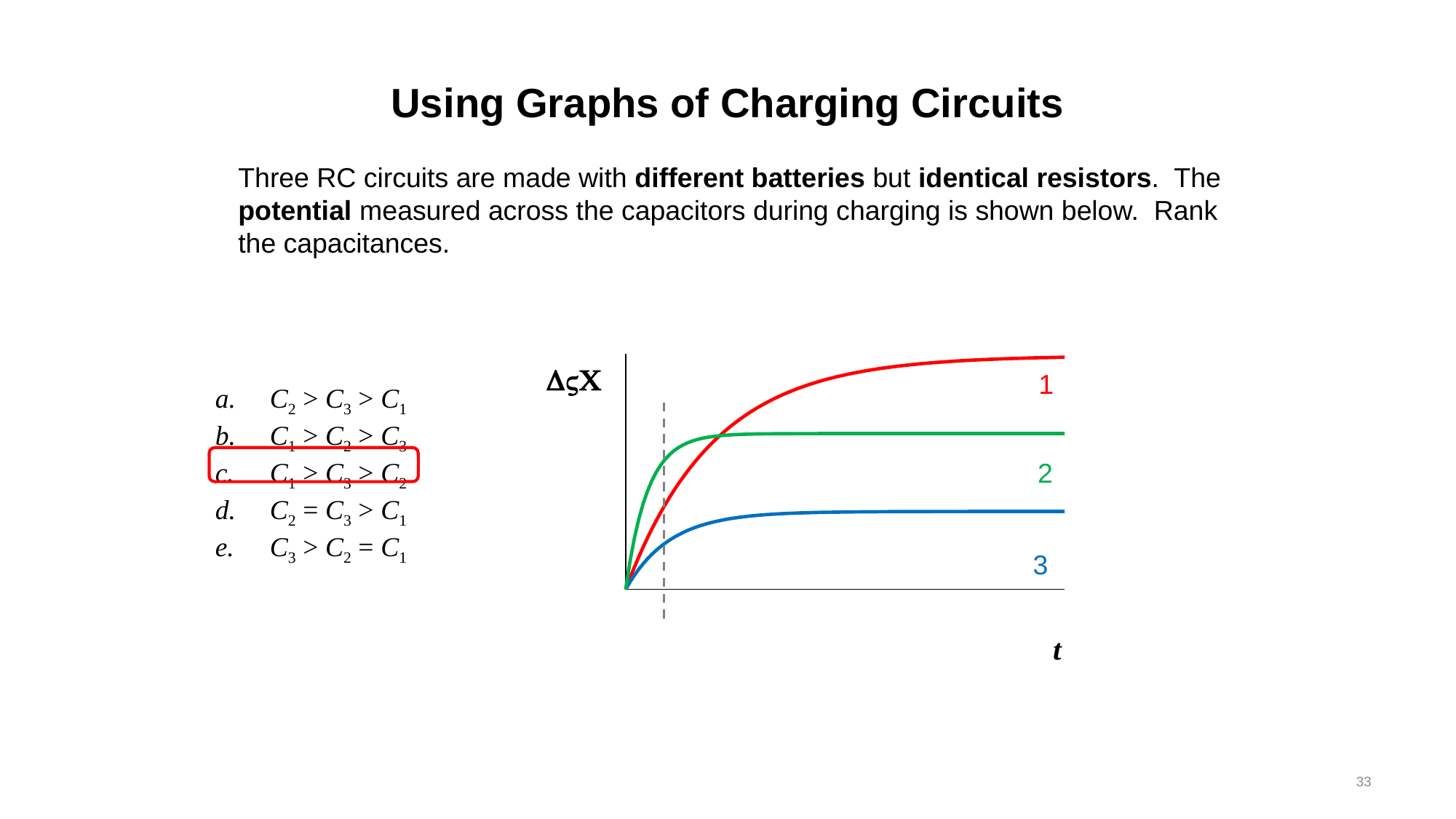
What colour is curve 1? red Which curve reaches its plateau soonest? 2 How many curves are plotted on the chart? 3 At the right end of the chart, which curve is higher, curve 2 or curve 3? curve 2 What kind of chart is shown on the slide? line chart Do the plotted potentials rise or fall as t increases? rise What is the label on the horizontal axis? t At the dashed vertical line, which curve has the lowest potential? 3 At the dashed vertical line, which curve is higher, curve 1 or curve 2? curve 2 Which curve levels off at the lowest potential? 3 Which curve reaches the highest potential at the right end of the chart? 1